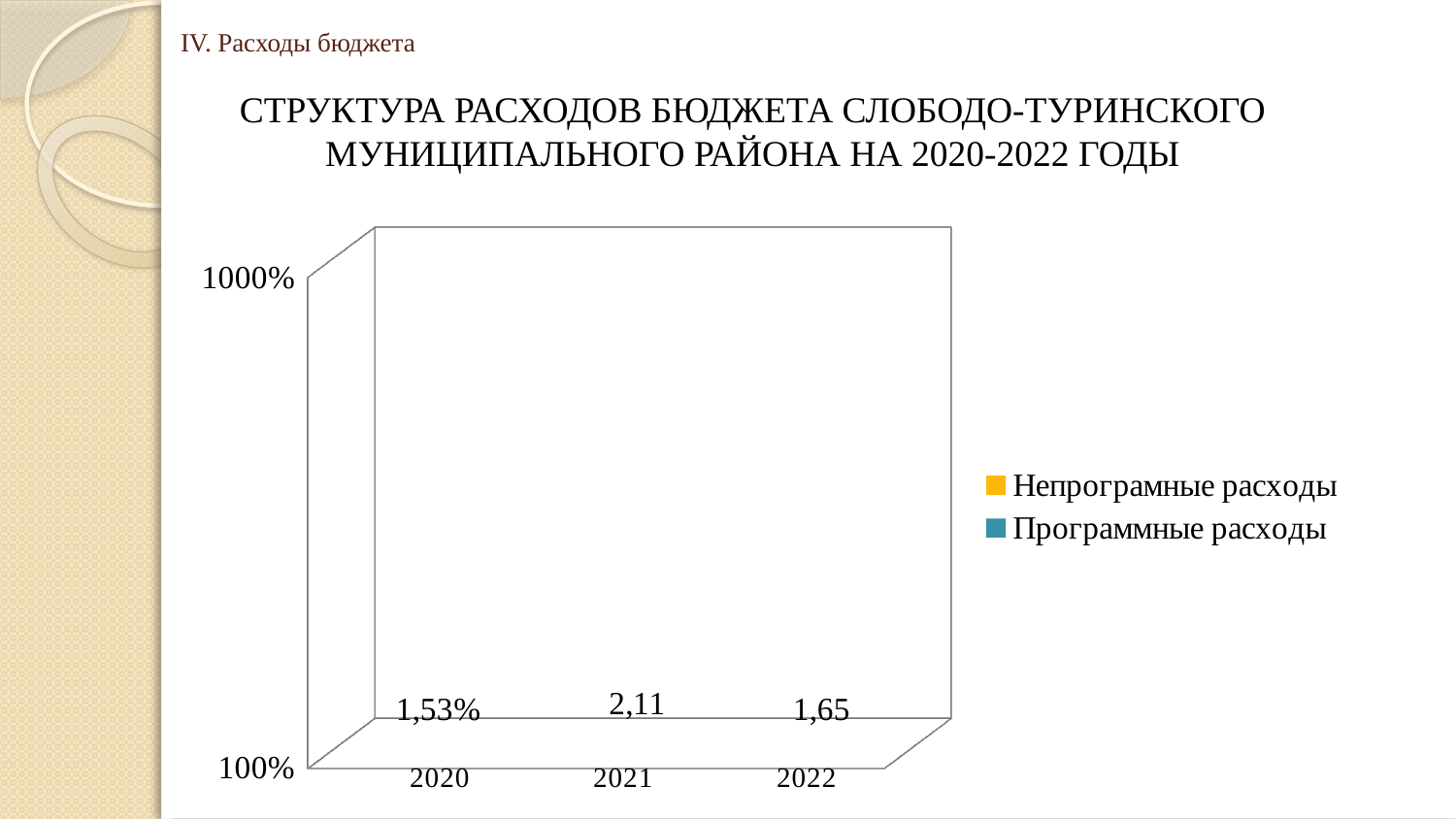
Which printed data label is larger, the one for 2020 or the one for 2022? 2022 What data label is printed at the 2022 category? 1,65 What data label is printed at the 2020 category? 1,53% What are the two series named in the chart legend? Непрограмные расходы and Программные расходы Which year has the lowest printed data label? 2020 Which series is shown in orange in the legend? Непрограмные расходы How many categories (years) are shown on the x axis of the chart? 3 Which year has the highest printed data label? 2021 What data label is printed at the 2021 category? 2,11 Which years are listed along the x axis of the chart? 2020, 2021, 2022 How many series does the chart legend list? 2